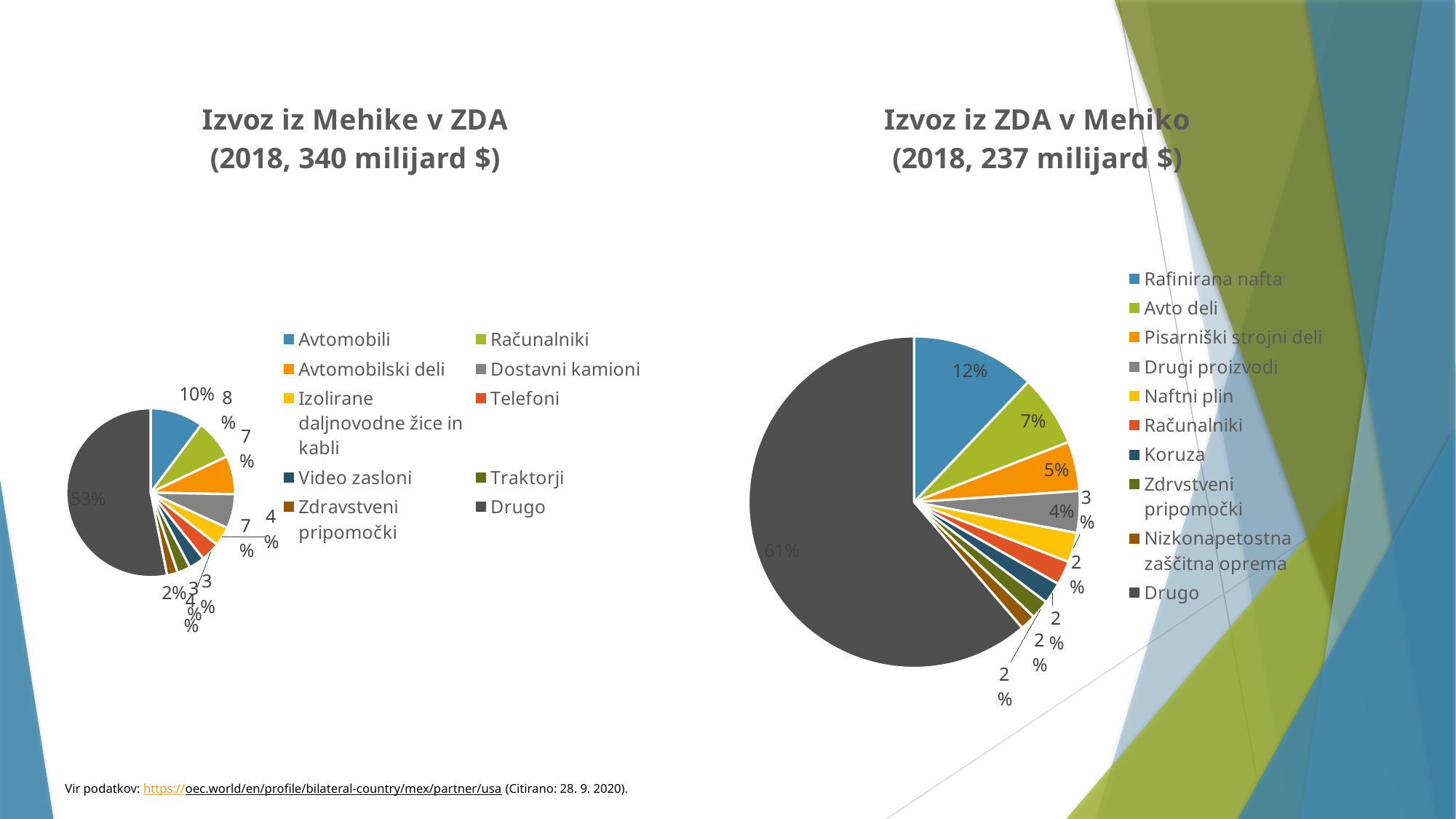
In the chart 'Izvoz iz ZDA v Mehiko', what share of exports is 'Pisarniški strojni deli'? 5% In the chart 'Izvoz iz ZDA v Mehiko', what is the difference in percentage points between 'Rafinirana nafta' and 'Avto deli'? 5 In the chart 'Izvoz iz Mehike v ZDA', what share is labelled for 'Drugo'? 53% In the chart 'Izvoz iz Mehike v ZDA', what share of exports is 'Zdravstveni pripomočki'? 2% In the chart 'Izvoz iz ZDA v Mehiko', which named product category (excluding 'Drugo') has the largest share? Rafinirana nafta What type of chart is 'Izvoz iz Mehike v ZDA'? Pie chart In the chart 'Izvoz iz Mehike v ZDA', what share of exports is 'Računalniki'? 8% How many categories does the legend of the chart 'Izvoz iz ZDA v Mehiko' list? 10 In the chart 'Izvoz iz Mehike v ZDA', which is larger: 'Avtomobili' or 'Računalniki'? Avtomobili In the chart 'Izvoz iz ZDA v Mehiko', which category has the largest slice? Drugo In the chart 'Izvoz iz ZDA v Mehiko', what share of exports is 'Rafinirana nafta'? 12% In the chart 'Izvoz iz Mehike v ZDA', what share of exports is 'Avtomobili'? 10%